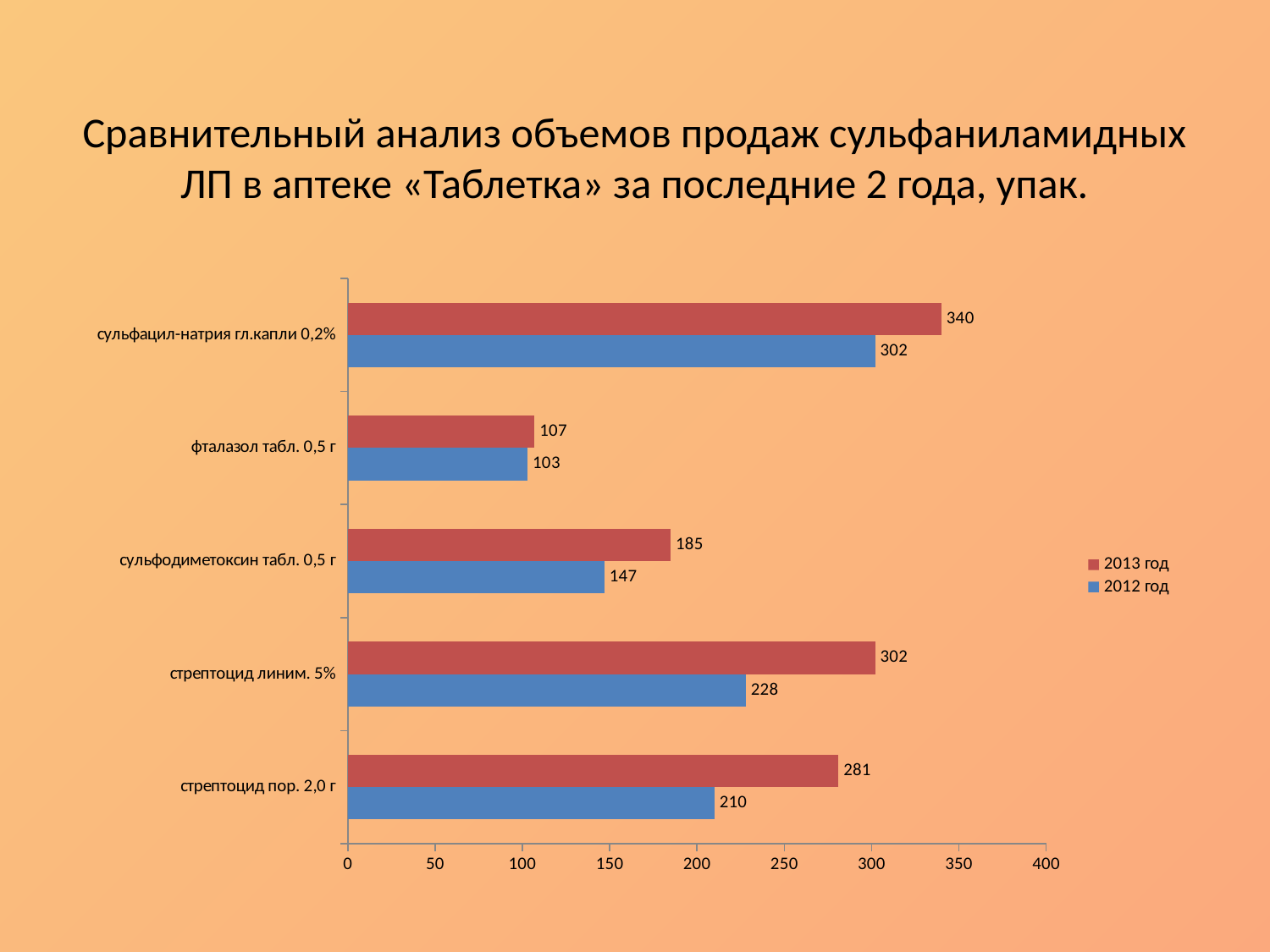
How many series does the legend list? 2 What is the difference between the 2013 год and 2012 год values for стрептоцид линим. 5%? 74 What was the 2013 год value for сульфацил-натрия гл.капли 0,2%? 340 What was the 2012 год value for стрептоцид пор. 2,0 г? 210 Which is larger for фталазол табл. 0,5 г: the 2013 год value or the 2012 год value? 2013 год Which category has the lowest 2012 год value? фталазол табл. 0,5 г How many categories (drugs) are shown on the chart? 5 What kind of chart is shown on the slide? bar chart Which category has the highest 2013 год value? сульфацил-натрия гл.капли 0,2% Is the 2013 год value for стрептоцид пор. 2,0 г greater or less than 250? greater Which colour represents 2012 год in the chart? blue What was the 2012 год value for сульфодиметоксин табл. 0,5 г? 147